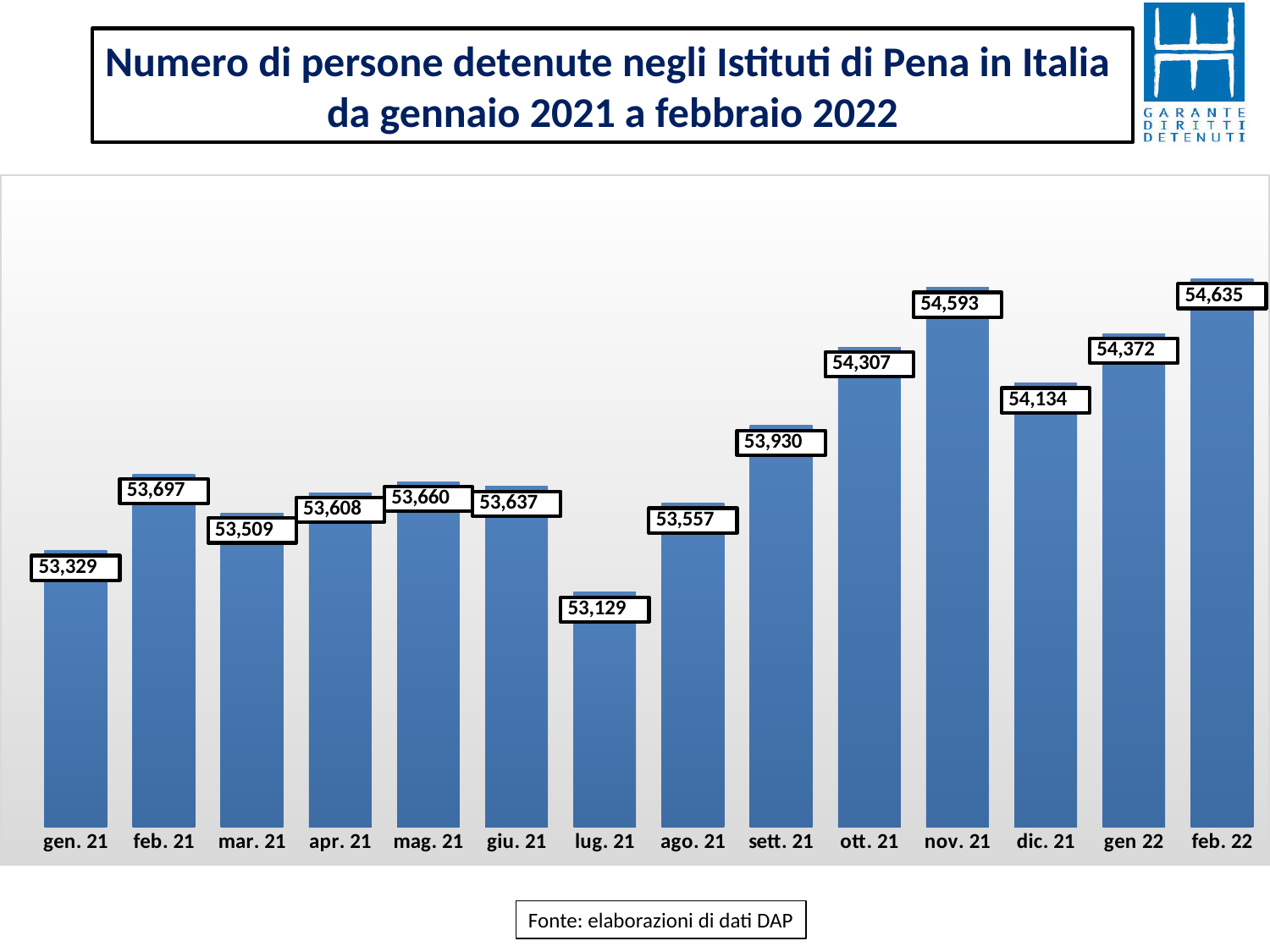
What is the difference between the values for nov. 21 and dic. 21? 459 Which is larger, the value for ott. 21 or the value for gen 22? gen 22 What kind of chart is shown on the slide? bar chart What is the title of the chart? Numero di persone detenute negli Istituti di Pena in Italia da gennaio 2021 a febbraio 2022 What is the value for nov. 21? 54,593 Which month has the highest value? feb. 22 What is the difference between the values for feb. 22 and gen. 21? 1,306 Which month has the lowest value? lug. 21 What is the value for sett. 21? 53,930 What is the value for gen. 21? 53,329 What is the value for lug. 21? 53,129 How many months are shown on the x axis? 14